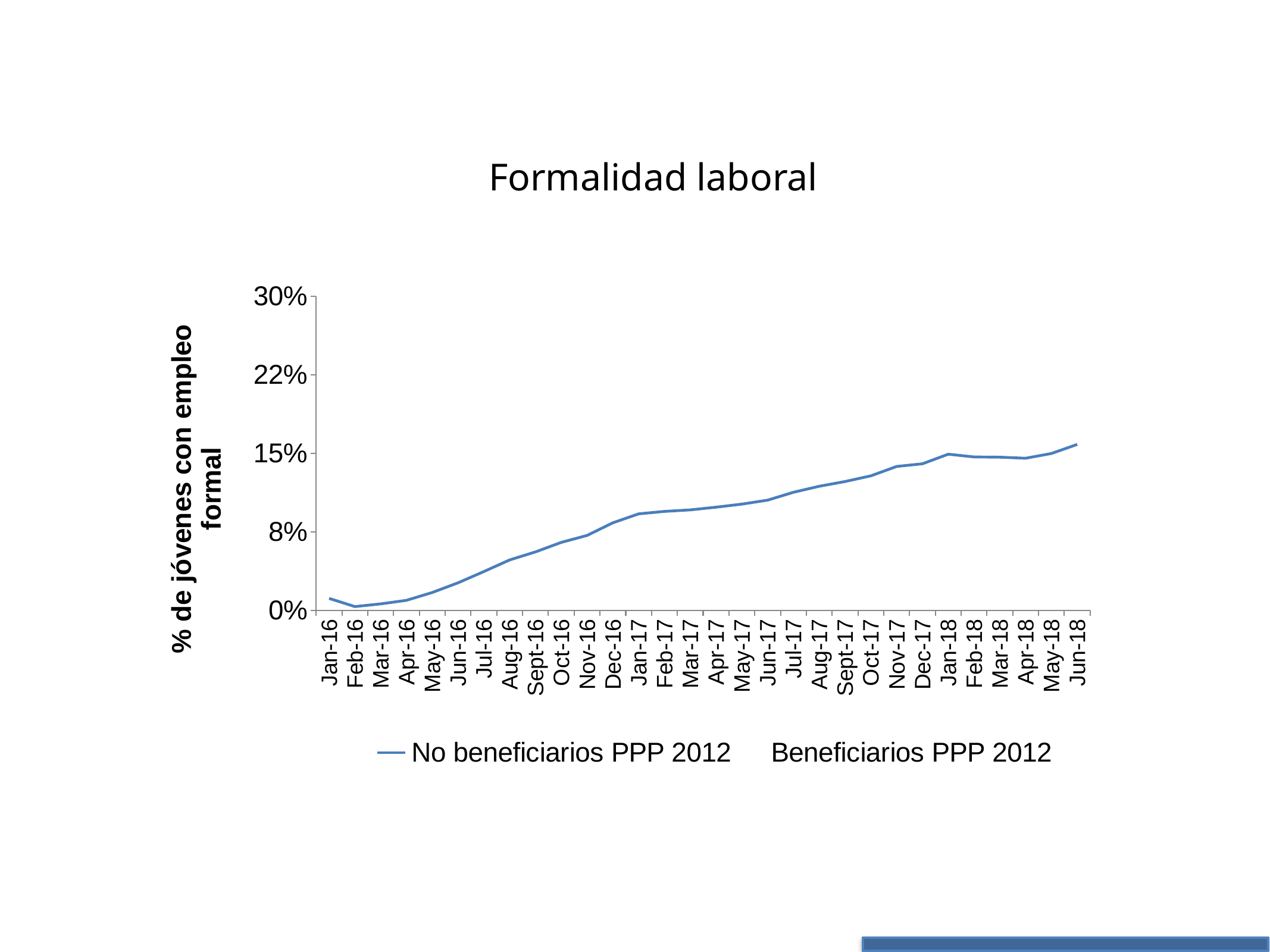
What is the title of the chart? Formalidad laboral What kind of chart is shown on the slide? line chart Which month has the lowest value for No beneficiarios PPP 2012? Feb-16 Is the value for No beneficiarios PPP 2012 in Jan-16 greater or less than 8%? less Is the value for No beneficiarios PPP 2012 in Jan-17 greater or less than 8%? greater Which month has the highest value for No beneficiarios PPP 2012? Jun-18 How many months are shown on the x axis? 30 Is the value for No beneficiarios PPP 2012 in Jun-17 greater or less than 15%? less How many series does the legend list? 2 Does the No beneficiarios PPP 2012 line generally rise or fall from Jan-16 to Jun-18? rise Which is larger for No beneficiarios PPP 2012: the value in Dec-16 or the value in Dec-17? Dec-17